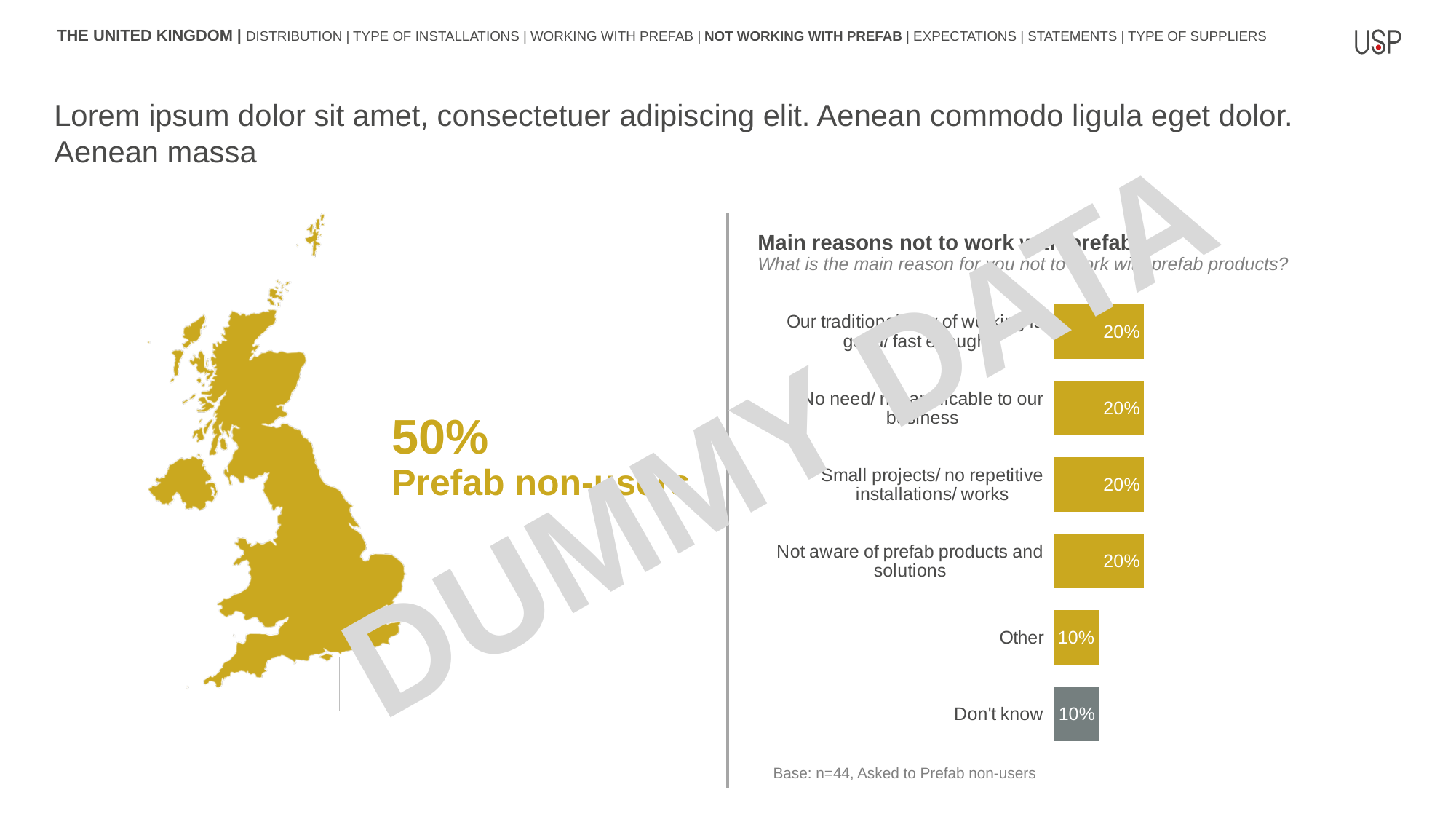
What is the value for "Small projects/ no repetitive installations/ works" in the Main reasons not to work with prefab chart? 20% What is the value for "Not aware of prefab products and solutions" in the Main reasons not to work with prefab chart? 20% What is the base noted under the Main reasons not to work with prefab chart? n=44, Asked to Prefab non-users How many categories are shown in the Main reasons not to work with prefab chart? 6 In the Main reasons not to work with prefab chart, which bar is coloured grey rather than gold? Don't know In the Main reasons not to work with prefab chart, what is the difference between "Not aware of prefab products and solutions" and "Don't know"? 10 percentage points In the Main reasons not to work with prefab chart, which is larger: "Not aware of prefab products and solutions" or "Other"? Not aware of prefab products and solutions What is the value for "Don't know" in the Main reasons not to work with prefab chart? 10% What is the value for "Other" in the Main reasons not to work with prefab chart? 10% In the Main reasons not to work with prefab chart, which is larger: "Don't know" or "Small projects/ no repetitive installations/ works"? Small projects/ no repetitive installations/ works What kind of chart is the Main reasons not to work with prefab chart? Bar chart